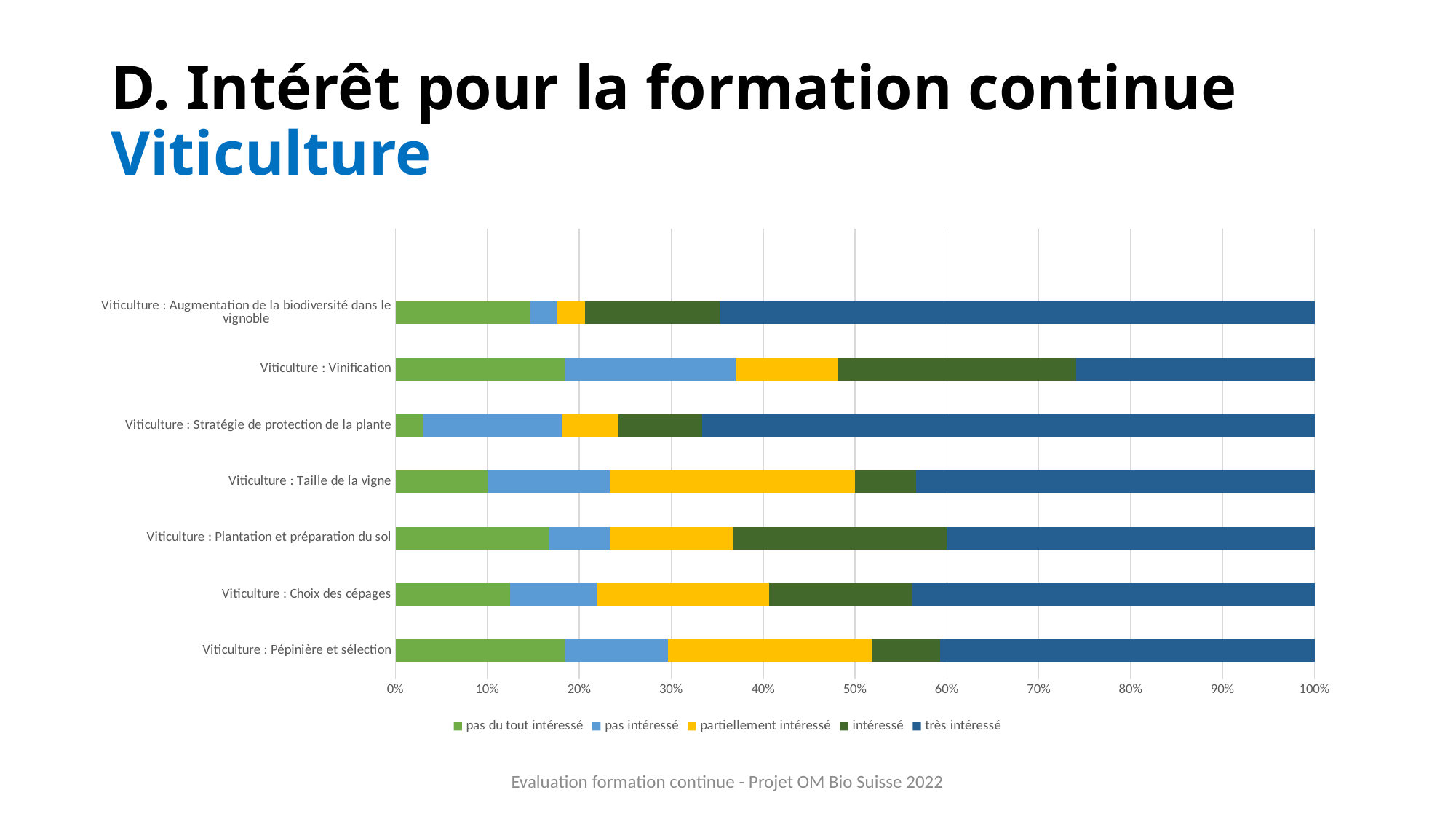
Is the 'pas du tout intéressé' share for 'Viticulture : Vinification' greater or less than 10%? greater What kind of chart is shown on the slide? Stacked bar chart Is the 'pas du tout intéressé' share for 'Viticulture : Stratégie de protection de la plante' greater or less than 10%? less Which category has the smallest 'pas du tout intéressé' share? Viticulture : Stratégie de protection de la plante Is the 'pas du tout intéressé' share for 'Viticulture : Plantation et préparation du sol' greater or less than 10%? greater Which has the larger 'pas intéressé' share: 'Viticulture : Stratégie de protection de la plante' or 'Viticulture : Augmentation de la biodiversité dans le vignoble'? Viticulture : Stratégie de protection de la plante Which has the larger 'pas du tout intéressé' share: 'Viticulture : Vinification' or 'Viticulture : Stratégie de protection de la plante'? Viticulture : Vinification What colour represents the 'très intéressé' series? Dark blue Which category has the largest 'partiellement intéressé' share? Viticulture : Taille de la vigne How many categories (training topics) are plotted on the chart? 7 What is the first entry in the chart legend? pas du tout intéressé How many series does the legend list? 5